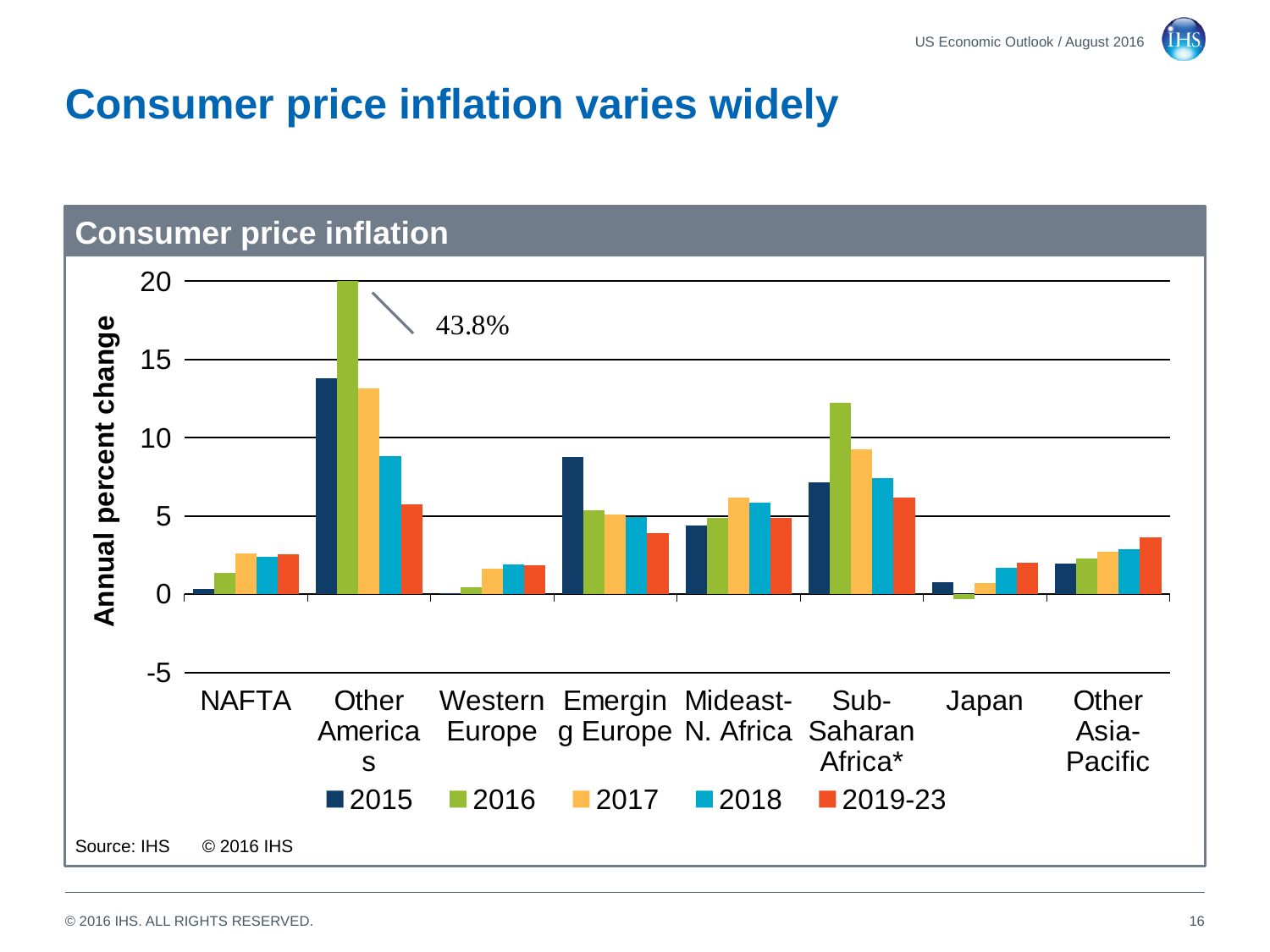
Which is larger, the 2015 value for Other Americas or the 2015 value for Emerging Europe? Other Americas Is the 2015 value for Emerging Europe greater or less than 5? greater What value is annotated for the 2016 bar for Other Americas? 43.8% Is the 2016 value for Sub-Saharan Africa* greater or less than 10? greater What is the label on the y axis of the chart? Annual percent change How many series does the legend of the chart list? 5 For Other Asia-Pacific, do the bars rise or fall from 2015 through 2019-23? rise Which region has the highest 2016 consumer price inflation? Other Americas Is the 2015 value for NAFTA greater or less than 5? less Which region has the lowest 2016 consumer price inflation? Japan What kind of chart is shown under the title "Consumer price inflation"? bar chart How many regions are shown along the x axis of the chart? 8